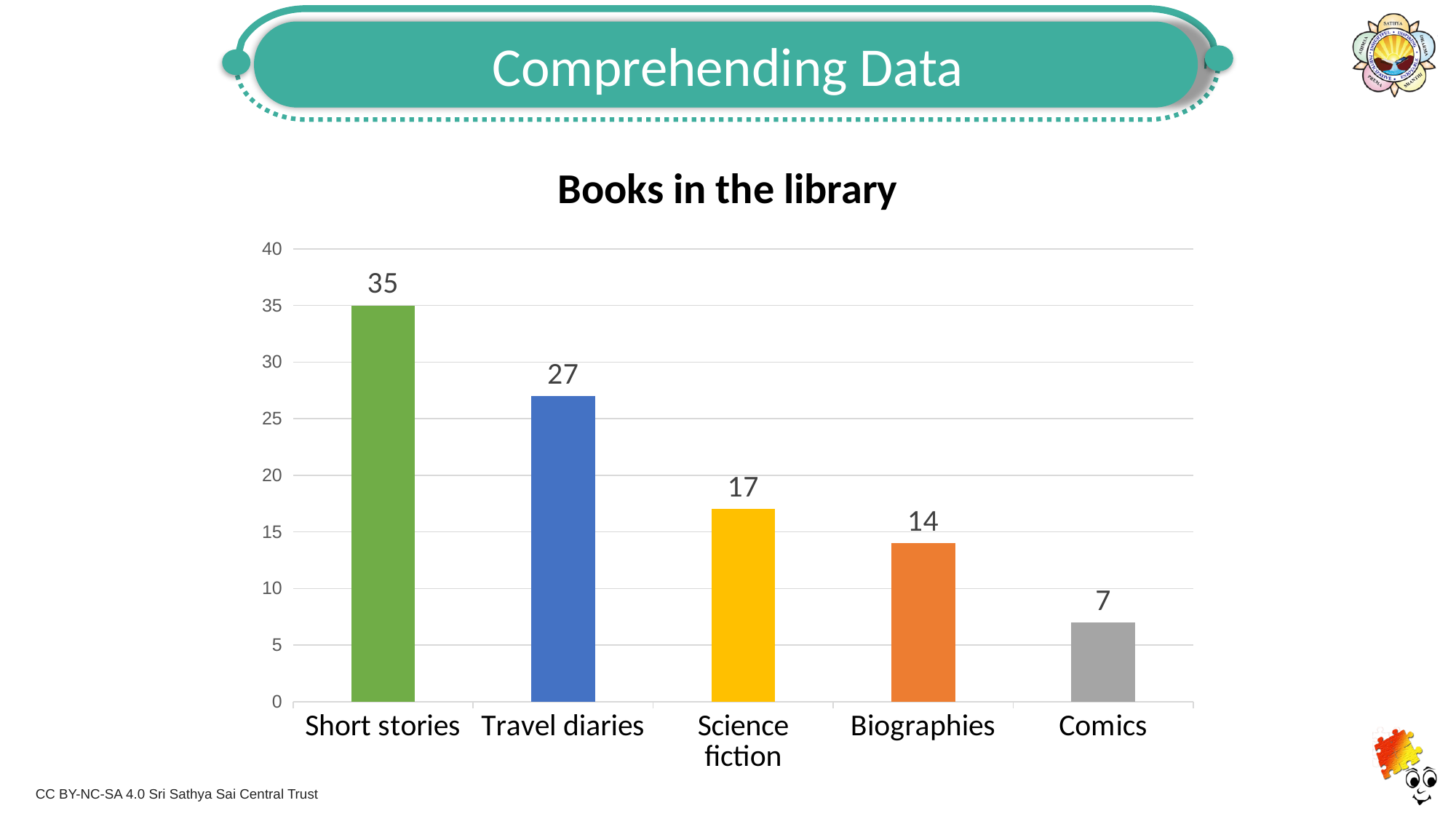
How many short stories books are in the library? 35 Is the value for Science fiction greater or less than 20? less What is the value for Science fiction? 17 How many categories are shown on the chart? 5 Which category has the highest number of books? Short stories What is the title of the chart? Books in the library What is the value for Comics? 7 Which is larger, the value for Travel diaries or the value for Biographies? Travel diaries What is the difference between the values for Short stories and Travel diaries? 8 What is the difference between the values for Biographies and Comics? 7 Which category has the lowest number of books? Comics What kind of chart is shown on the slide? bar chart